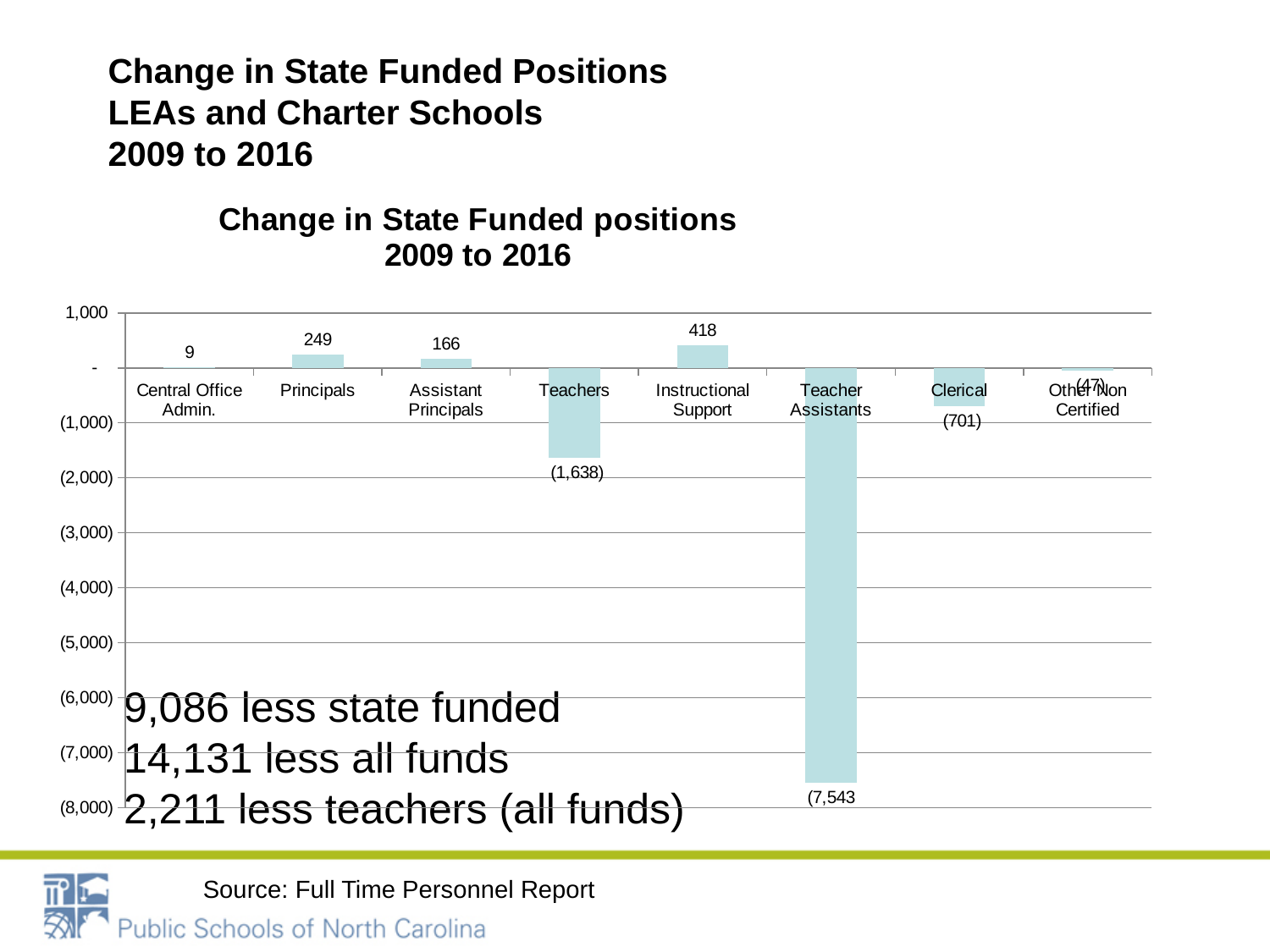
What is the value for Central Office Admin.? 9 Which category has the highest value? Instructional Support What is the value for Teachers? (1,638) How many categories are shown on the x axis? 8 What is the value for Principals? 249 What is the difference between the values for Principals and Assistant Principals? 83 Is the value for Teacher Assistants greater or less than (7,000)? less Which is larger, the value for Principals or the value for Assistant Principals? Principals What is the value for Clerical? (701) What is the value for Instructional Support? 418 What kind of chart is shown on the slide? bar chart Which category has the lowest value? Teacher Assistants